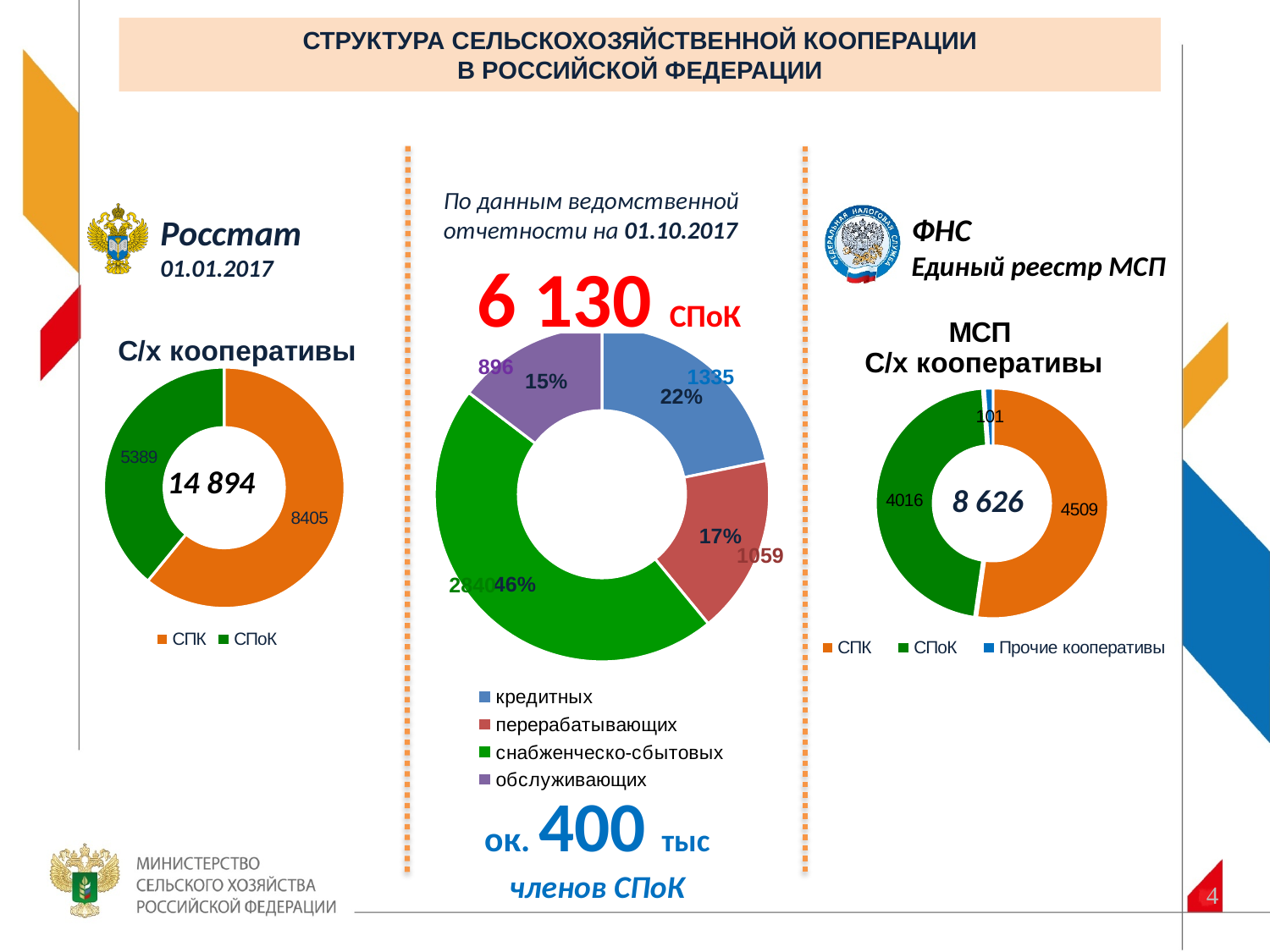
In the middle chart (6 130 СПоК), how many categories does the legend list? 4 In the left chart titled 'С/х кооперативы', what is the value for СПоК? 5389 In the right chart titled 'МСП С/х кооперативы', which category has the smallest value? Прочие кооперативы In the left chart titled 'С/х кооперативы', what is the difference between the СПК and СПоК values? 3016 In the middle chart (6 130 СПоК), what is the value for обслуживающих? 896 What kind of chart is the right chart titled 'МСП С/х кооперативы'? doughnut chart In the middle chart (6 130 СПоК), what is the value for кредитных? 1335 In the middle chart (6 130 СПоК), what percentage share is shown for снабженческо-сбытовых? 46% In the left chart titled 'С/х кооперативы', how many series does the legend list? 2 In the middle chart (6 130 СПоК), which category has the largest share? снабженческо-сбытовых In the right chart titled 'МСП С/х кооперативы', what is the value for Прочие кооперативы? 101 In the left chart titled 'С/х кооперативы', what is the value for СПК? 8405